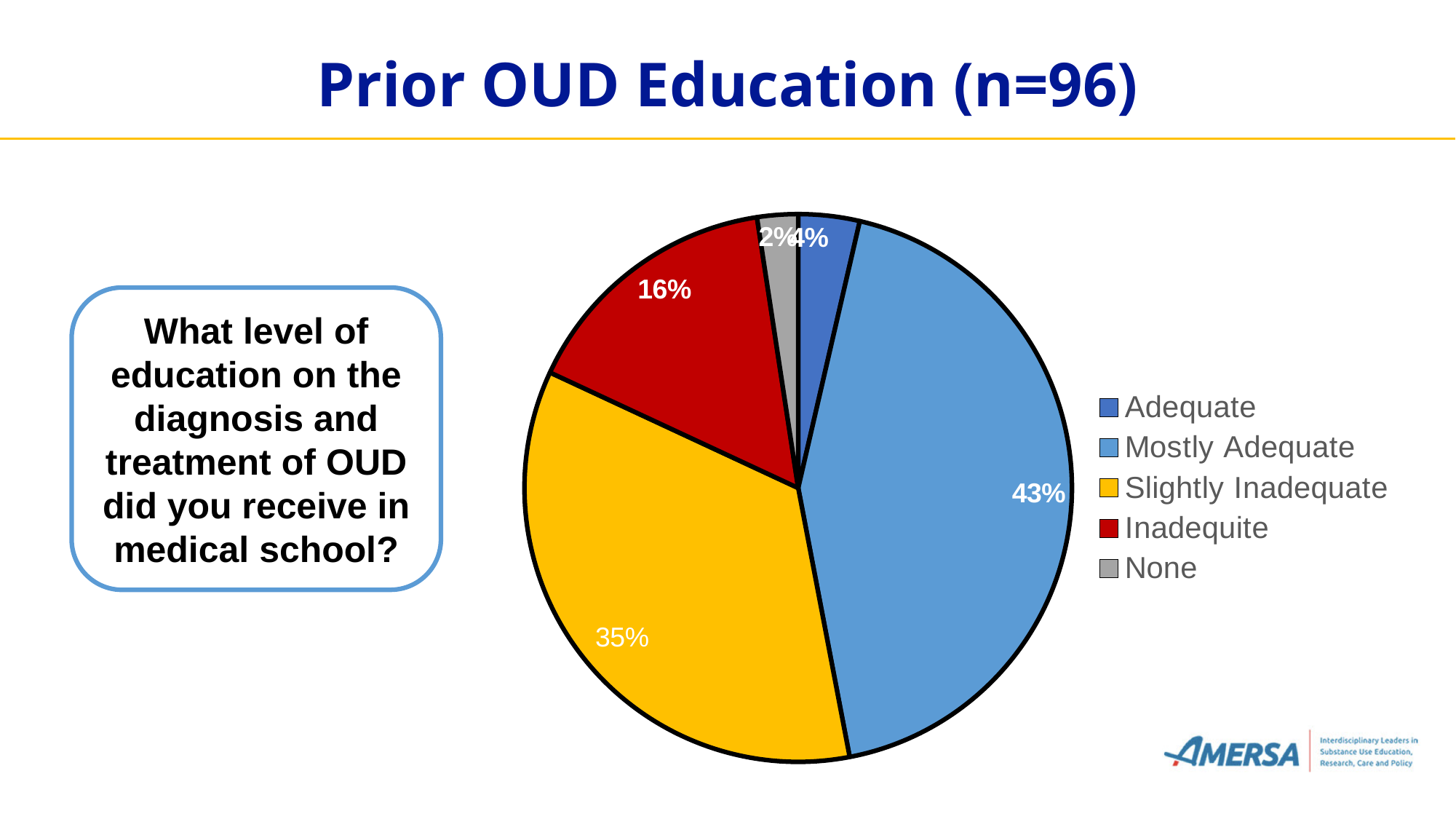
What percentage of respondents reported their prior OUD education was Mostly Adequate? 43% How many categories does the legend list? 5 What is the difference in percentage points between the Mostly Adequate and Slightly Inadequate slices? 8 Which slice is larger, Inadequite or Adequate? Inadequite Which category has the smallest share of the pie? None What percentage of respondents reported their prior OUD education was Inadequite? 16% What is the title of the slide containing the pie chart? Prior OUD Education (n=96) Which category has the largest share of the pie? Mostly Adequate What percentage of respondents reported their prior OUD education was Slightly Inadequate? 35% What percentage of respondents reported receiving no prior OUD education (None)? 2% What type of chart is shown on the slide? Pie chart What colour is the Slightly Inadequate slice? Yellow